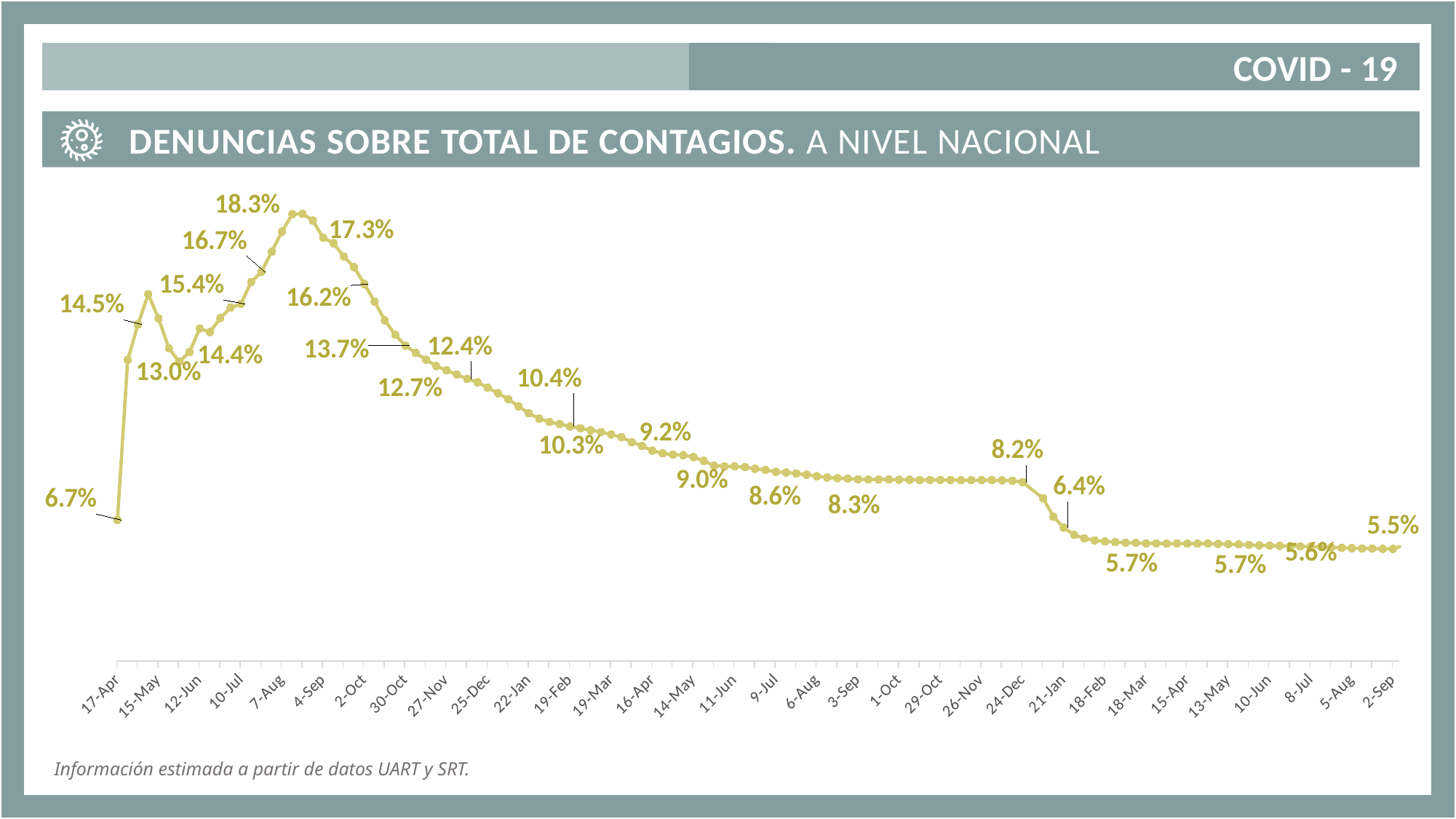
Is the value at the last point (2-Sep) greater or less than the value at the first point (17-Apr)? less What is the value at the last point of the line, at 2-Sep? 5.5% What is the difference between the peak value of 18.3% and the final value of 5.5%? 12.8 percentage points Which is larger, the labelled value 14.5% near the start or the labelled value 13.0% just after it? 14.5% After reaching its peak of 18.3%, does the line generally rise or fall toward 2-Sep? fall What is the lowest value labelled on the line? 5.5% What is the highest value labelled on the line? 18.3% What is the source note printed below the chart? Información estimada a partir de datos UART y SRT. What is the title of the chart? DENUNCIAS SOBRE TOTAL DE CONTAGIOS. A NIVEL NACIONAL What is the value at the first point of the line, at 17-Apr? 6.7% What kind of chart is shown on the slide? line chart What is the difference between the peak value of 18.3% and the first value of 6.7%? 11.6 percentage points